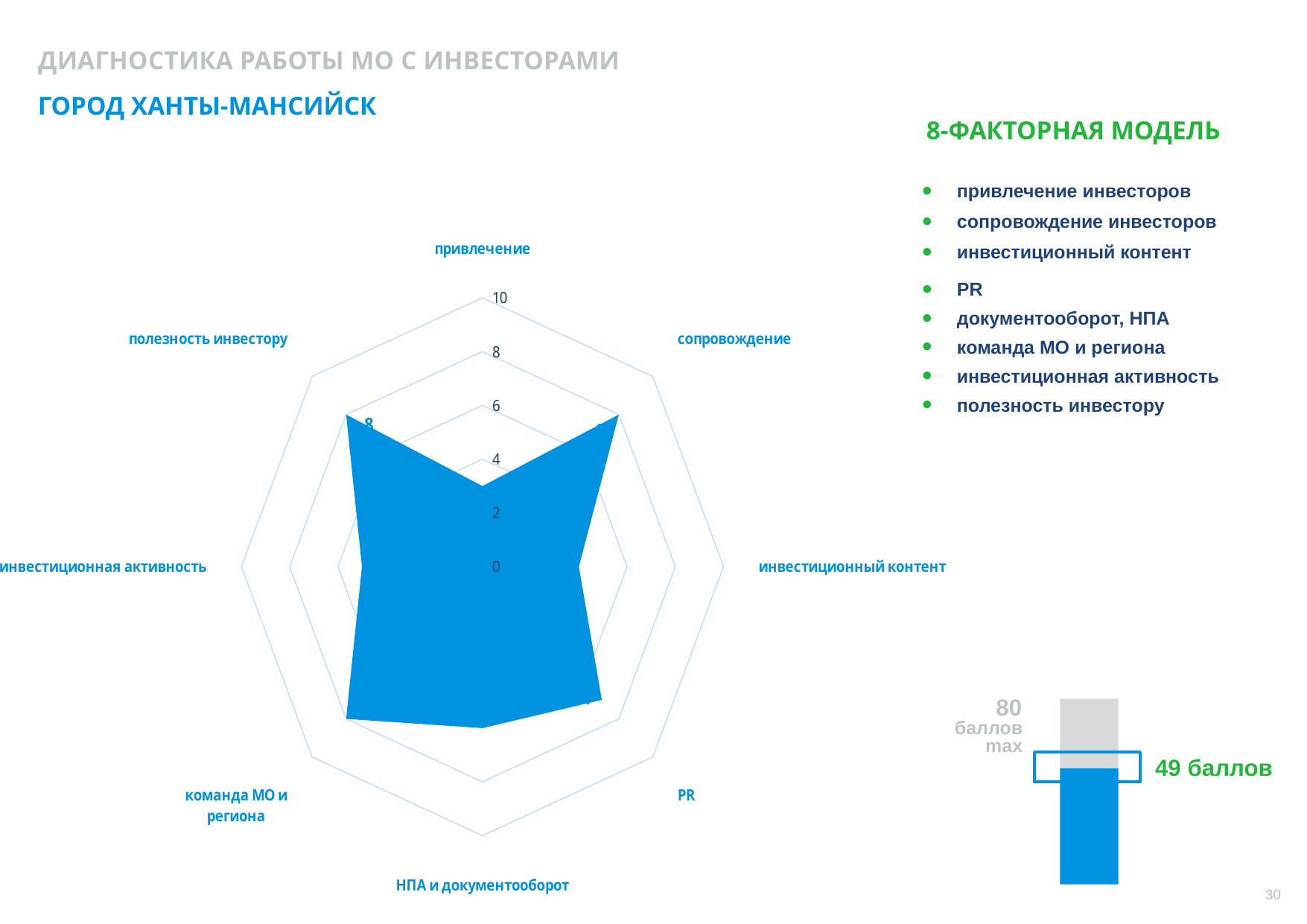
On the radar chart, is the value for сопровождение greater or less than 6? greater On the bar at the bottom right, what is the maximum possible score? 80 баллов On the bar at the bottom right, what score is shown for the city? 49 баллов On the radar chart, what is the value for полезность инвестору? 8 What is the maximum value shown on the radar chart's axis scale? 10 What kind of chart is the large chart on the left of the slide? radar chart How many categories (axes) does the radar chart have? 8 On the radar chart, which is larger: the value for сопровождение or the value for привлечение? сопровождение On the radar chart, is the value for привлечение greater or less than 4? less On the bar at the bottom right, how many points short of the maximum is the city's score? 31 On the radar chart, is the value for команда МО и региона greater or less than 6? greater On the radar chart, which is larger: the value for полезность инвестору or the value for инвестиционный контент? полезность инвестору